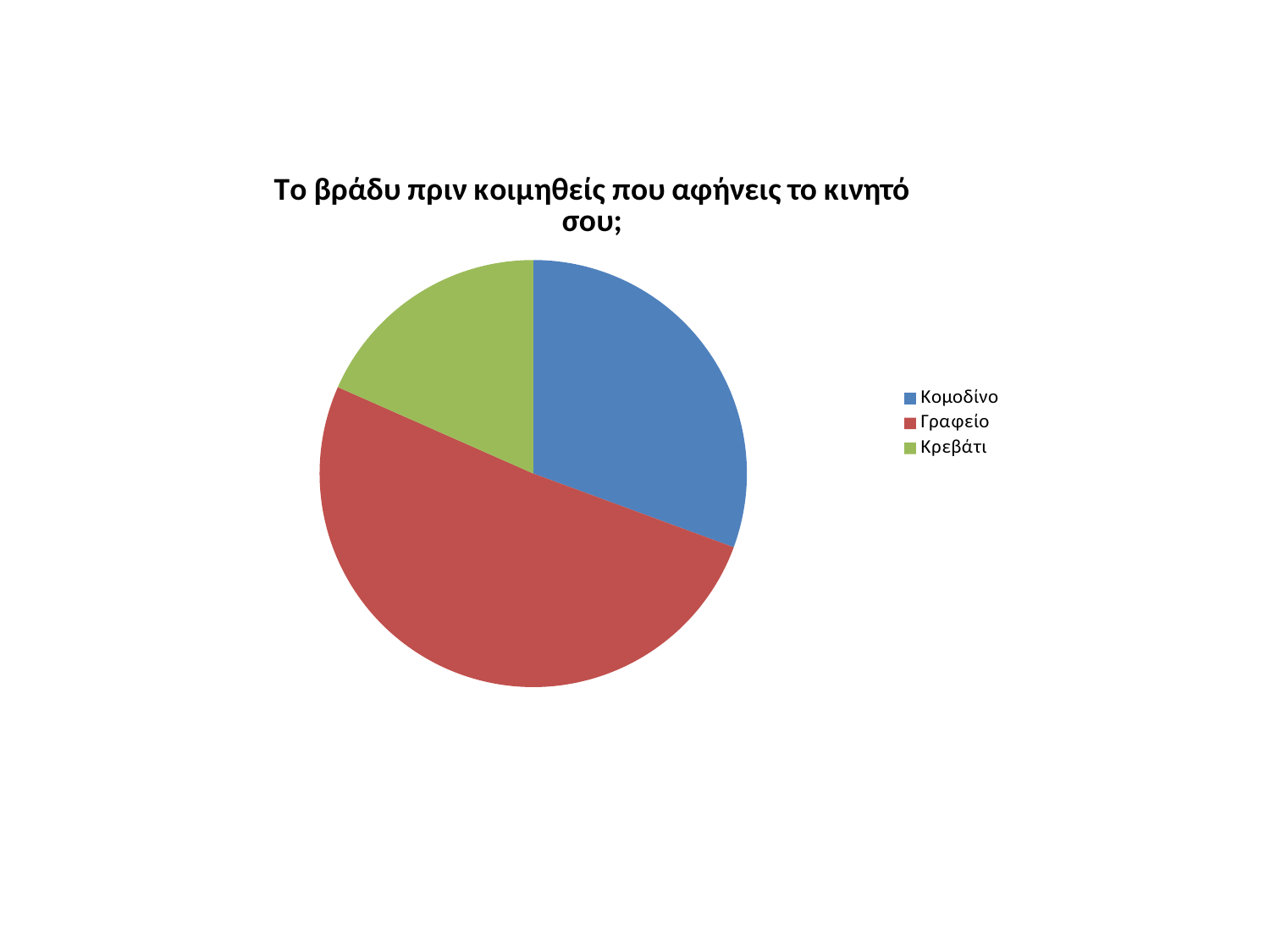
What is the title of the chart? Το βράδυ πριν κοιμηθείς που αφήνεις το κινητό σου; What kind of chart is shown on the slide? pie chart Which colour represents Γραφείο in the pie chart? red Which slice is larger, Γραφείο or Κομοδίνο? Γραφείο How many slices does the pie chart have? 3 How many entries does the legend list? 3 Which category has the smallest slice of the pie? Κρεβάτι Which category has the largest slice of the pie? Γραφείο Which slice is larger, Κομοδίνο or Κρεβάτι? Κομοδίνο